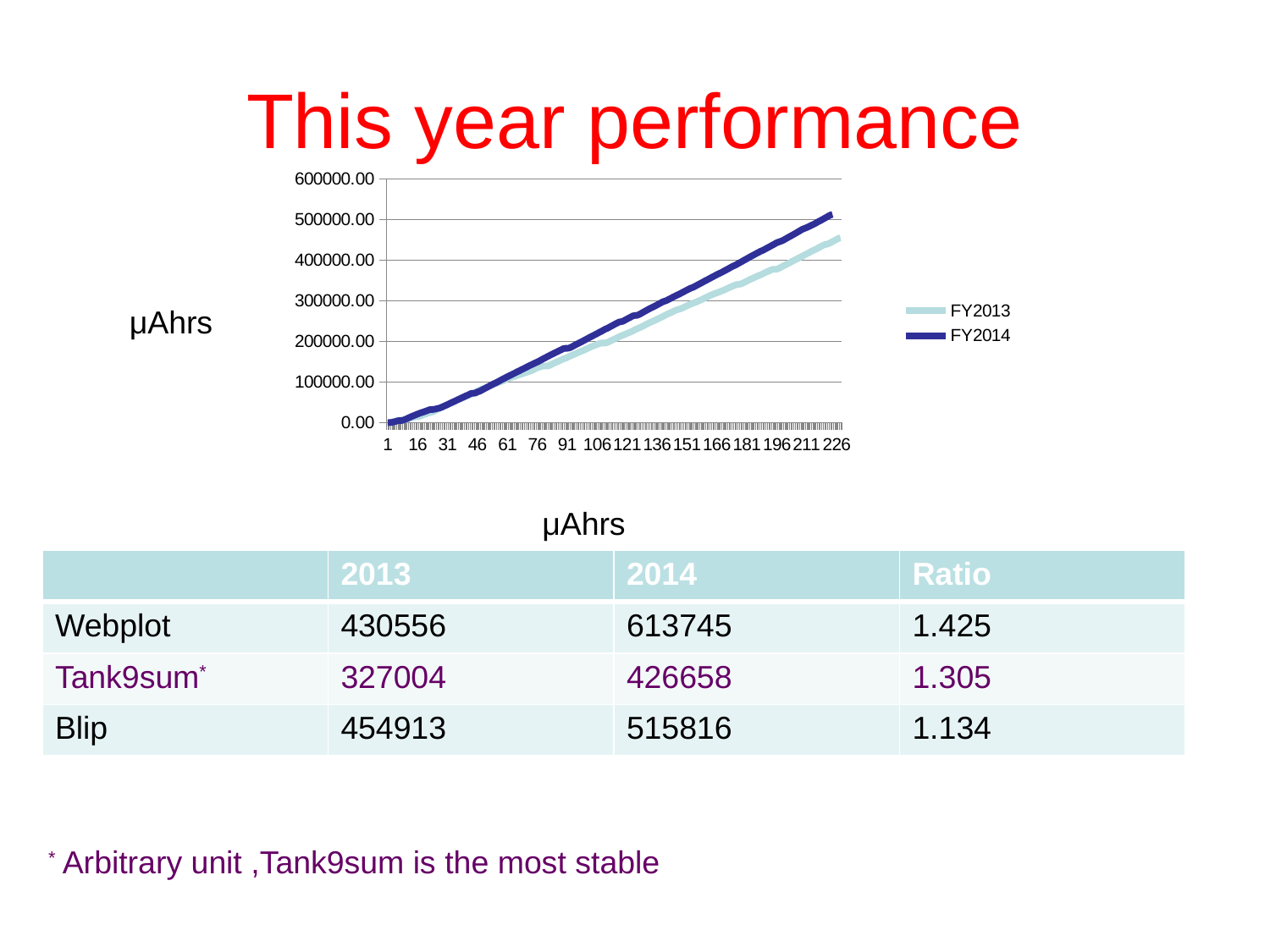
At the right end of the chart (x = 226), which series is higher, FY2013 or FY2014? FY2014 What is the highest tick value shown on the chart's y axis? 600000.00 Is the value of FY2013 at x = 226 greater or less than 500000.00? less What kind of chart is shown on the slide? line chart Do the values in the chart rise or fall as the x axis increases? rise How many series does the chart's legend list? 2 Is the value of FY2014 at x = 196 greater or less than 400000.00? greater Is the value of FY2014 at x = 226 greater or less than 400000.00? greater At x = 166, which series is higher, FY2013 or FY2014? FY2014 What are the two series named in the chart's legend? FY2013 and FY2014